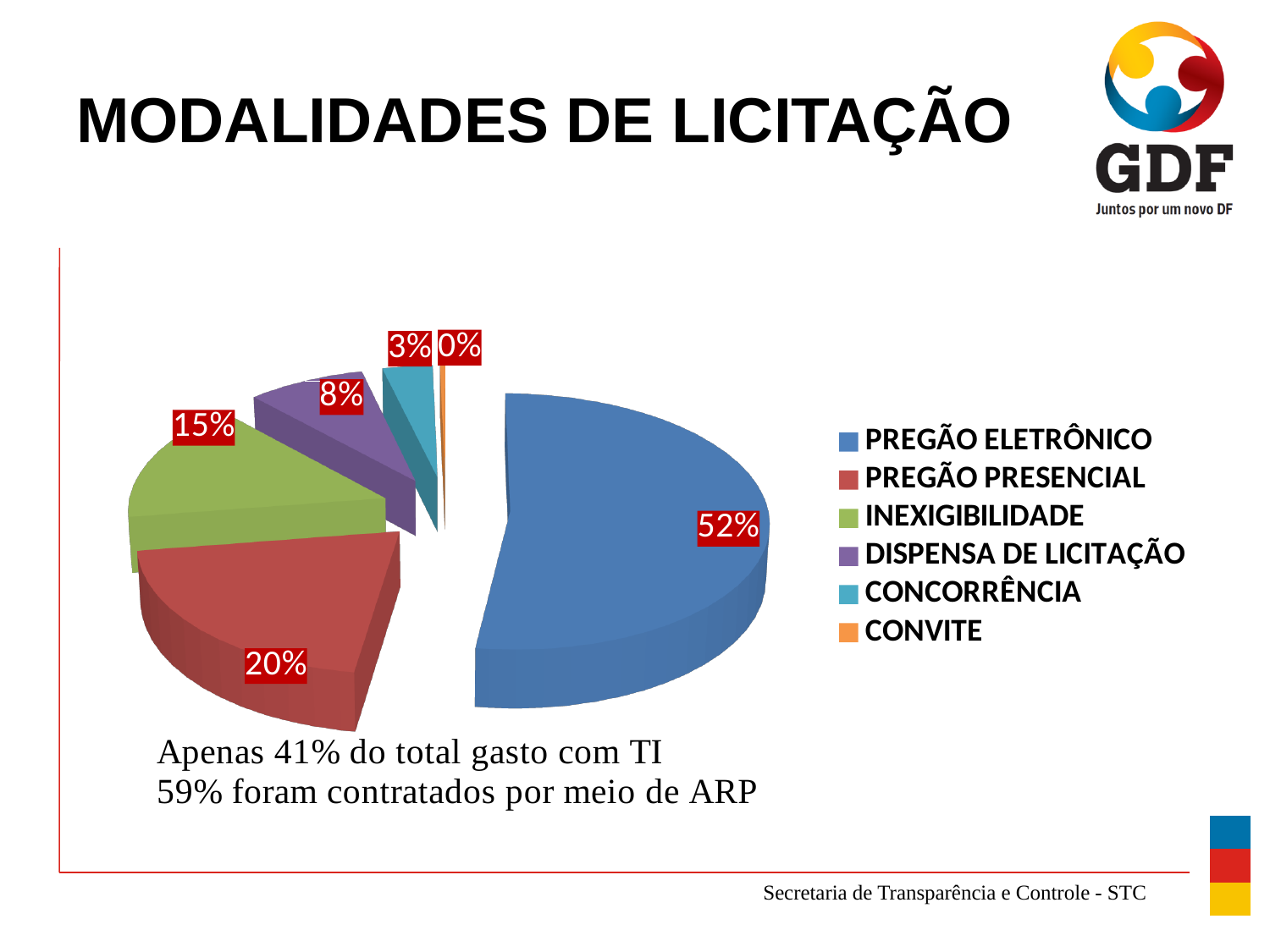
What share of the pie does PREGÃO PRESENCIAL represent? 20% What share of the pie does DISPENSA DE LICITAÇÃO represent? 8% What is the difference in percentage points between PREGÃO ELETRÔNICO and PREGÃO PRESENCIAL? 32 percentage points What share of the pie does CONCORRÊNCIA represent? 3% How many categories does the legend list? 6 Which is larger, INEXIGIBILIDADE or DISPENSA DE LICITAÇÃO? INEXIGIBILIDADE What share of the pie does PREGÃO ELETRÔNICO represent? 52% What kind of chart is shown on the slide? Pie chart What share of the pie does INEXIGIBILIDADE represent? 15% Which category has the largest slice of the pie? PREGÃO ELETRÔNICO Which category has the smallest slice of the pie? CONVITE What is the title of the slide containing the pie chart? MODALIDADES DE LICITAÇÃO